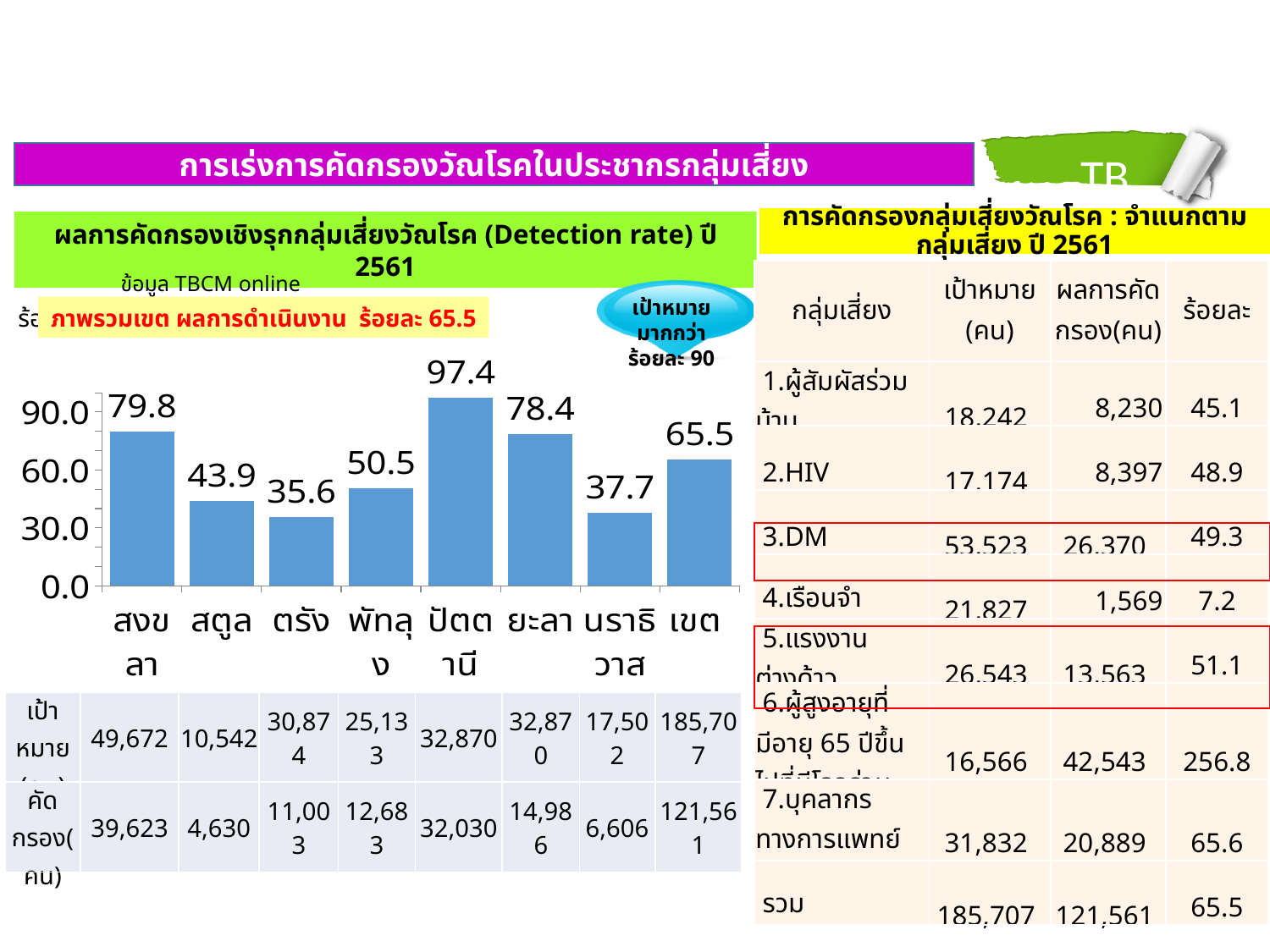
What kind of chart is shown on the slide? bar chart Is the value for นราธิวาส in the bar chart greater or less than 60.0? less What is the value for เขต in the bar chart? 65.5 What is the value for ปัตตานี in the bar chart? 97.4 How many categories are shown in the bar chart? 8 What is the value for ตรัง in the bar chart? 35.6 Which category has the lowest value in the bar chart? ตรัง What is the value for สงขลา in the bar chart? 79.8 What is the difference between the values for สงขลา and สตูล in the bar chart? 35.9 Which category has the highest value in the bar chart? ปัตตานี Which is larger in the bar chart, the value for สตูล or the value for พัทลุง? พัทลุง What is the difference between the values for ปัตตานี and ยะลา in the bar chart? 19.0